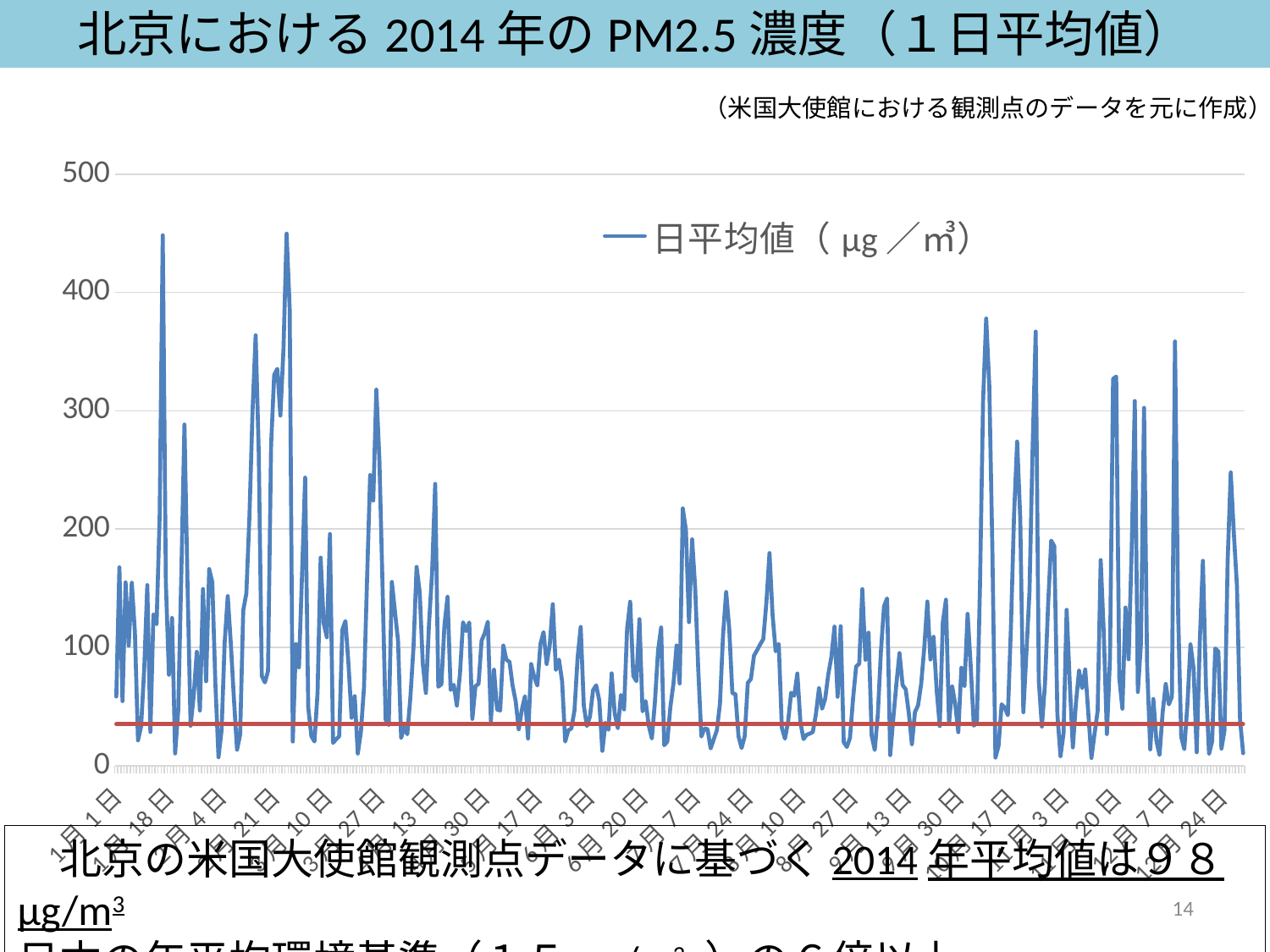
What is the lowest tick value shown on the vertical axis? 0 How many series does the chart legend list? 1 What is the title of the chart on the slide? 北京における2014年のPM2.5濃度（１日平均値） What is the legend entry of the plotted series? 日平均値（μg／㎥） Is the highest daily value plotted on the chart greater or less than 400? greater What is the highest tick value shown on the vertical axis? 500 Is the highest daily value plotted on the chart greater or less than 500? less What kind of chart is shown on the slide? line chart